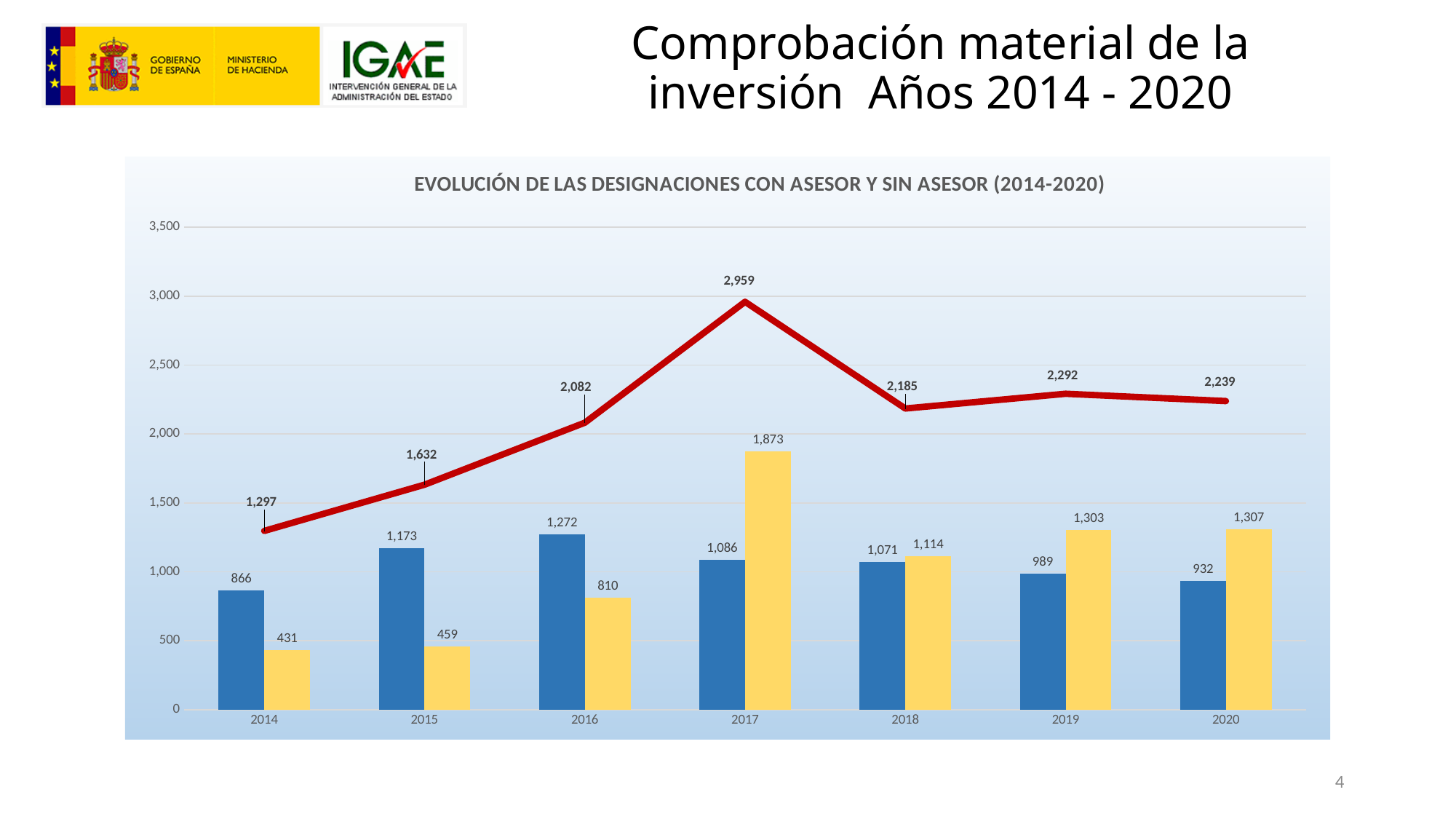
What is the value of the blue bar for 2016? 1,272 What value does the red line show for 2017? 2,959 In 2019, which is larger: the blue bar or the yellow bar? The yellow bar In which year is the yellow bar the lowest? 2014 Is the value of the blue bar for 2015 greater or less than 1,000? greater What is the value of the yellow bar for 2014? 431 What is the difference between the yellow bar and the blue bar in 2017? 787 In which year is the blue bar the highest? 2016 How many years are shown on the x axis? 7 Does the red line rise or fall from 2014 to 2017? It rises In which year does the red line reach its highest value? 2017 What kind of chart is shown on the slide? A bar chart combined with a line